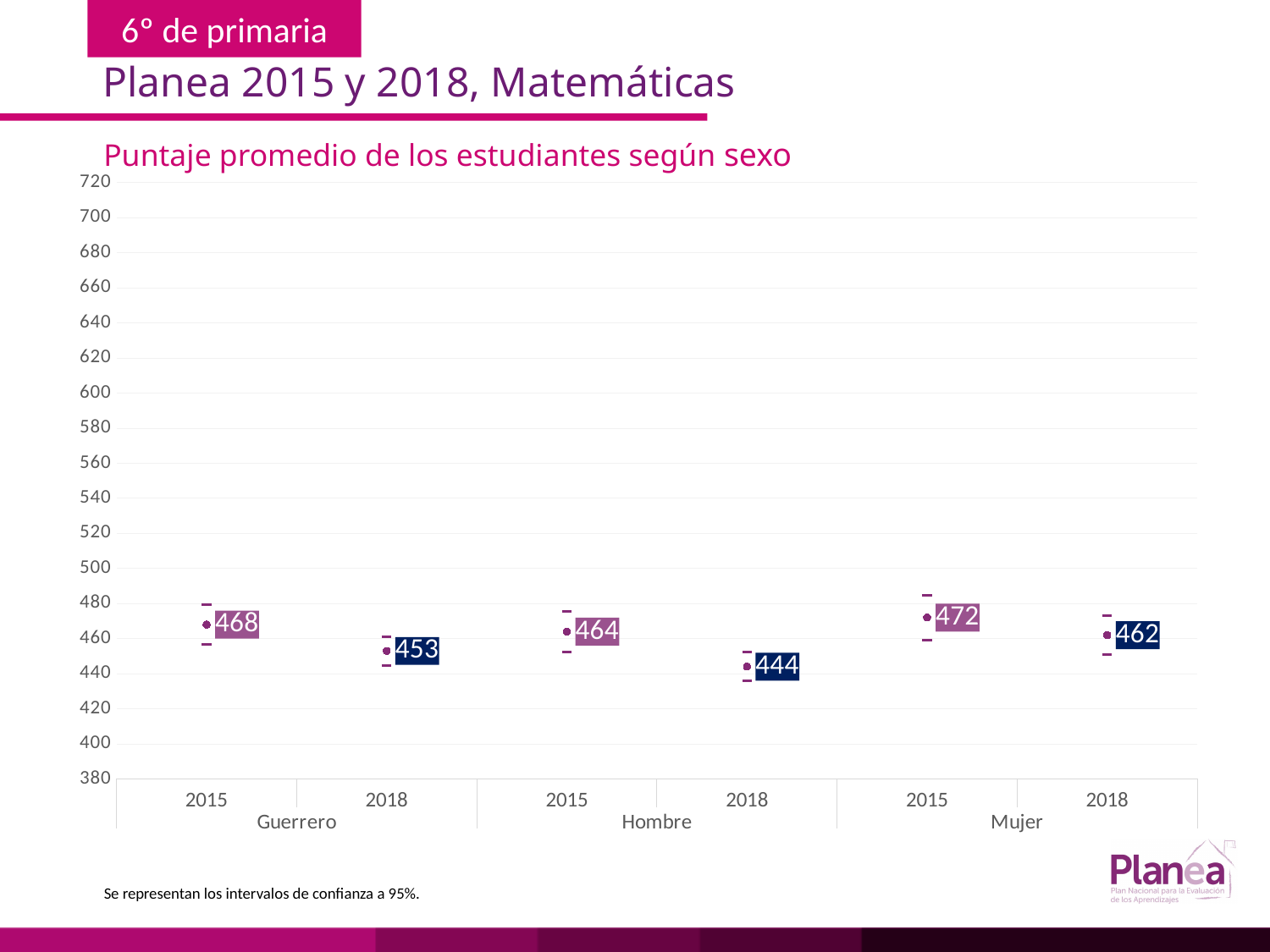
What is the title of the chart? Puntaje promedio de los estudiantes según sexo Which is larger, the Hombre 2015 score or the Mujer 2018 score? Hombre 2015 By how much did the Guerrero average score change from 2015 to 2018? 15 What is the average score for Guerrero in 2018? 453 What is the average score for Guerrero in 2015? 468 How many data points are plotted on the chart? 6 What is the average score for Hombre in 2018? 444 What is the average score for Mujer in 2015? 472 Did the average scores rise or fall from 2015 to 2018 in every group? fall What is the difference between the Mujer 2018 score and the Hombre 2018 score? 18 Which group and year has the lowest average score? Hombre 2018 Which group and year has the highest average score? Mujer 2015